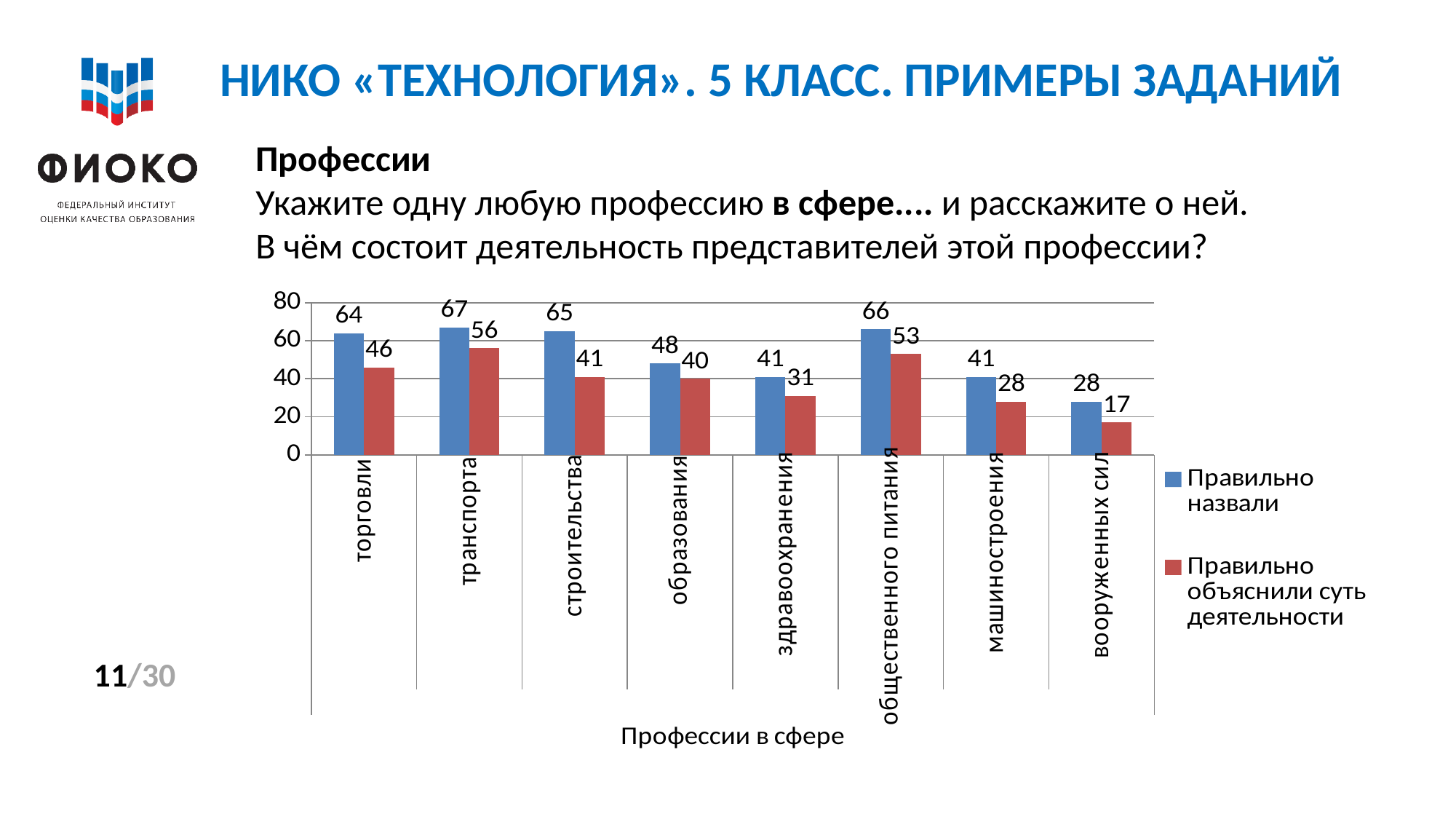
What is the value of "Правильно объяснили суть деятельности" for "общественного питания"? 53 What is the x-axis title of the chart? Профессии в сфере What is the difference between "Правильно назвали" and "Правильно объяснили суть деятельности" for "строительства"? 24 What is the value of "Правильно назвали" for "транспорта"? 67 Which category has the highest value for "Правильно назвали"? транспорта Which is larger: "Правильно назвали" for "торговли" or for "образования"? торговли What kind of chart is shown on the slide? bar chart How many categories are shown on the x axis? 8 How many series does the legend list? 2 What is the value of "Правильно объяснили суть деятельности" for "вооруженных сил"? 17 Is the value of "Правильно объяснили суть деятельности" for "транспорта" greater or less than 40? greater Which category has the lowest value for "Правильно объяснили суть деятельности"? вооруженных сил